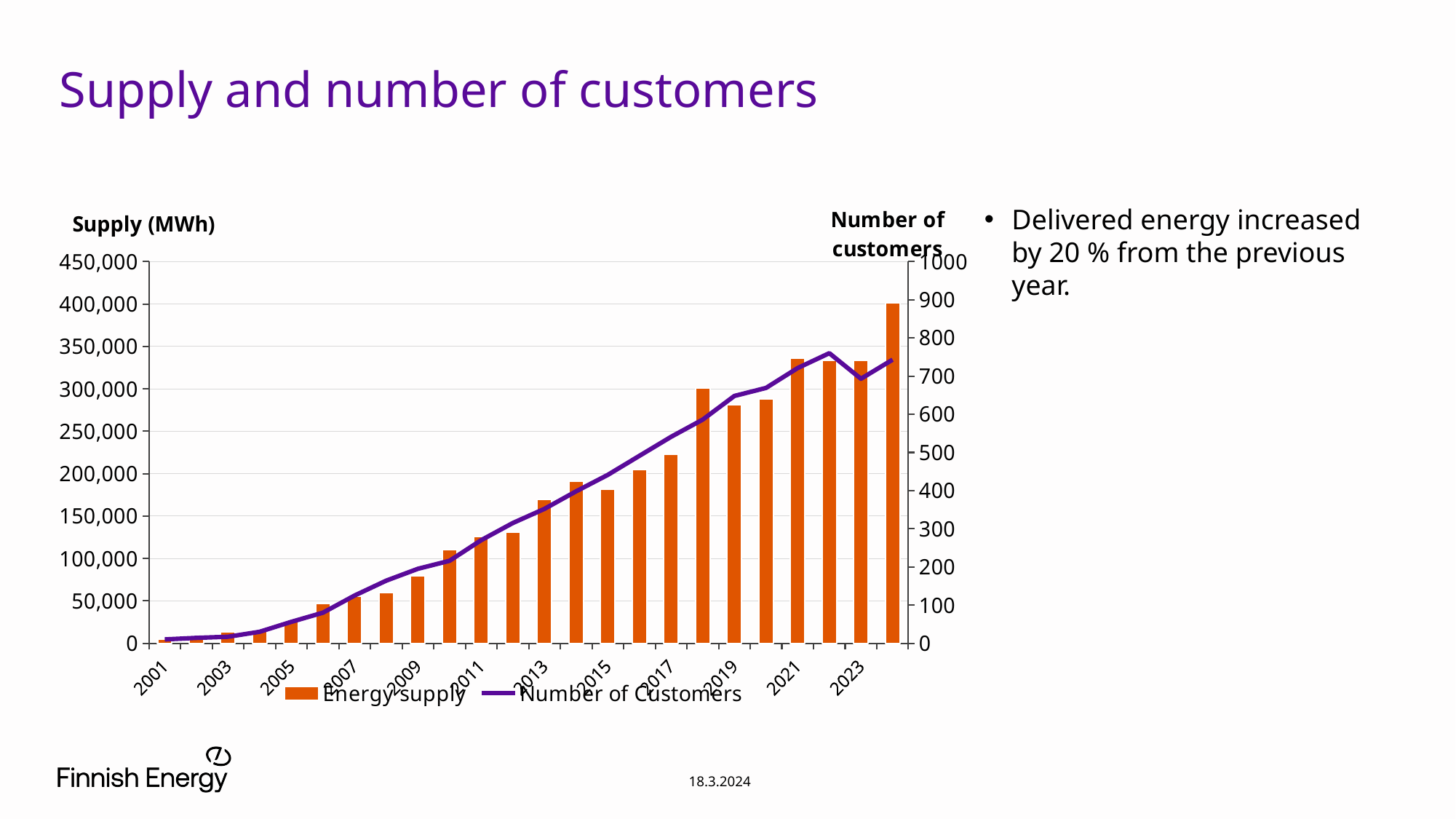
Which year has the highest energy supply bar? 2024 Is the energy supply value for 2024 greater or less than 350,000? greater How many series does the legend list? 2 What is the title of the left vertical axis? Supply (MWh) Which year has the lowest energy supply bar? 2001 Is the energy supply value for 2009 greater or less than 100,000? less Is the energy supply value for 2017 greater or less than 200,000? greater Does the number of customers line generally rise or fall from 2001 to 2024? rise What type of chart is shown on the slide? Combination bar and line chart Which year has the larger energy supply bar, 2018 or 2019? 2018